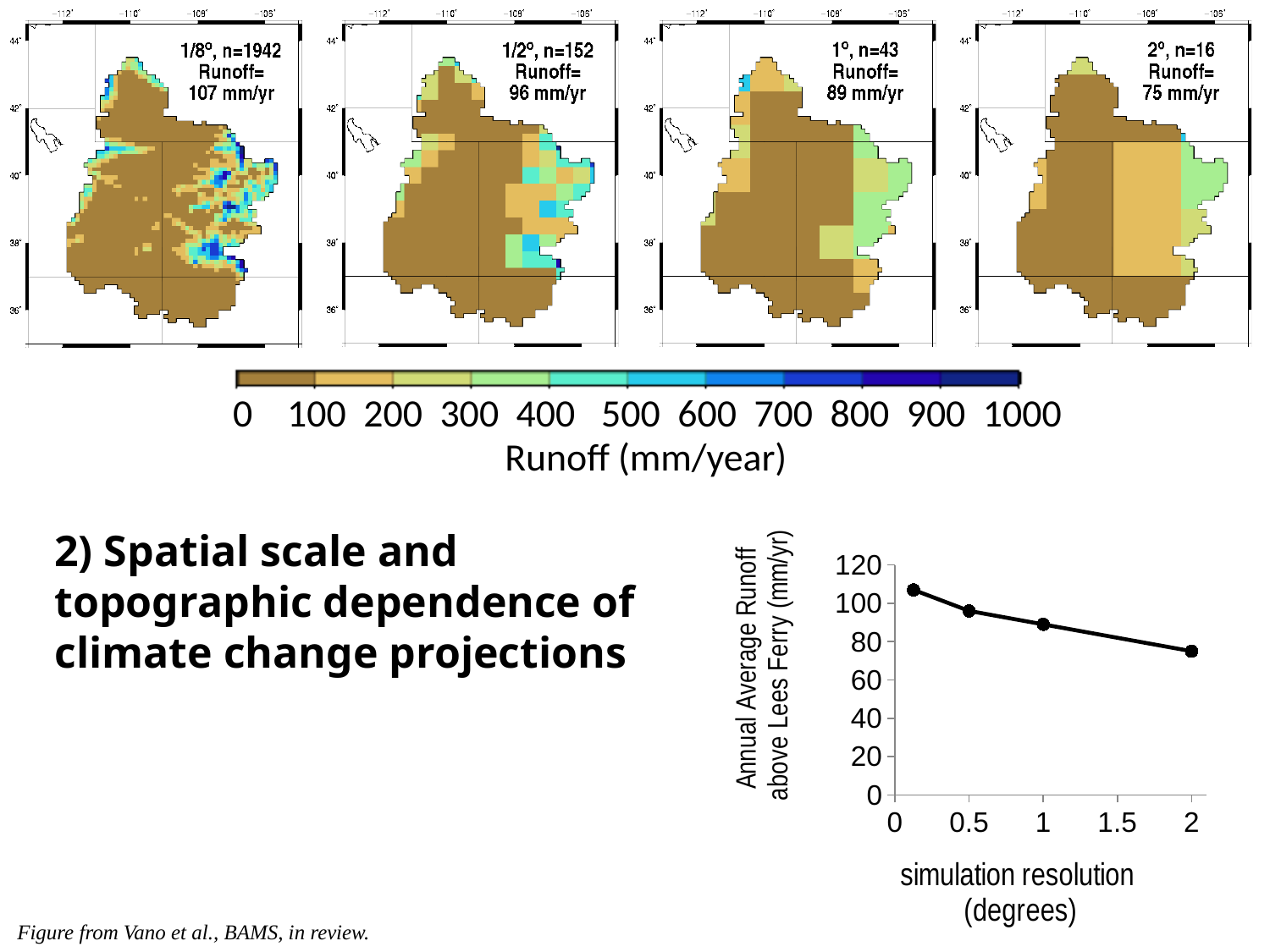
In the bottom-right line chart, is the value at a simulation resolution of 2 degrees greater or less than 80? less In the bottom-right line chart, is the value at a simulation resolution of 1 degree greater or less than 100? less In the bottom-right line chart, do the values rise or fall as simulation resolution increases along the x axis? fall In the bottom-right line chart, which simulation resolution has the highest annual average runoff? 1/8 degree (the smallest resolution) In the bottom-right line chart, is the value at the smallest simulation resolution greater or less than 100? greater According to the map panels, what is the runoff for the 2° simulation? 75 mm/yr According to the map panels, what is the difference in runoff between the 1/8° and 2° simulations? 32 mm/yr What kind of chart is shown at the bottom right of the slide? line chart In the bottom-right line chart, how many data points are plotted? 4 In the bottom-right line chart, which simulation resolution has the lowest annual average runoff? 2 degrees According to the map panels, what is the runoff for the 1/8° simulation? 107 mm/yr What is the y-axis label of the bottom-right line chart? Annual Average Runoff above Lees Ferry (mm/yr)